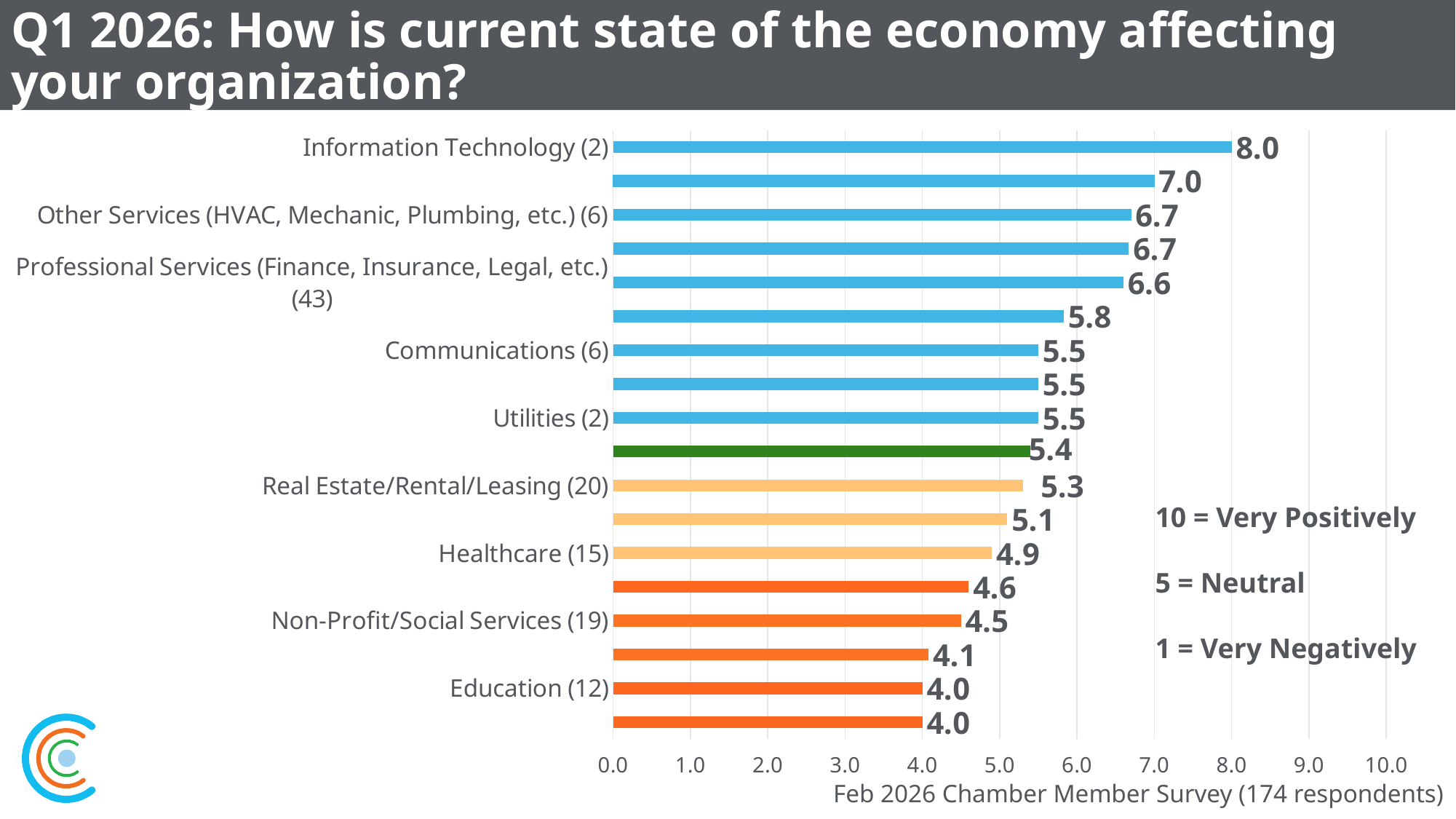
Which has a larger value, Real Estate/Rental/Leasing (20) or Non-Profit/Social Services (19)? Real Estate/Rental/Leasing (20) What kind of chart is shown on the slide? bar chart What is the value for Professional Services (Finance, Insurance, Legal, etc.) (43)? 6.6 What is the value for Information Technology (2)? 8.0 What is the value for Other Services (HVAC, Mechanic, Plumbing, etc.) (6)? 6.7 What is the value for Healthcare (15)? 4.9 What is the value for Education (12)? 4.0 What is the difference between the values for Information Technology (2) and Education (12)? 4.0 What is the value for Communications (6)? 5.5 How many bars are plotted in the chart? 18 Is the value for Utilities (2) greater or less than 5.0? greater Which labeled category has the highest value? Information Technology (2)